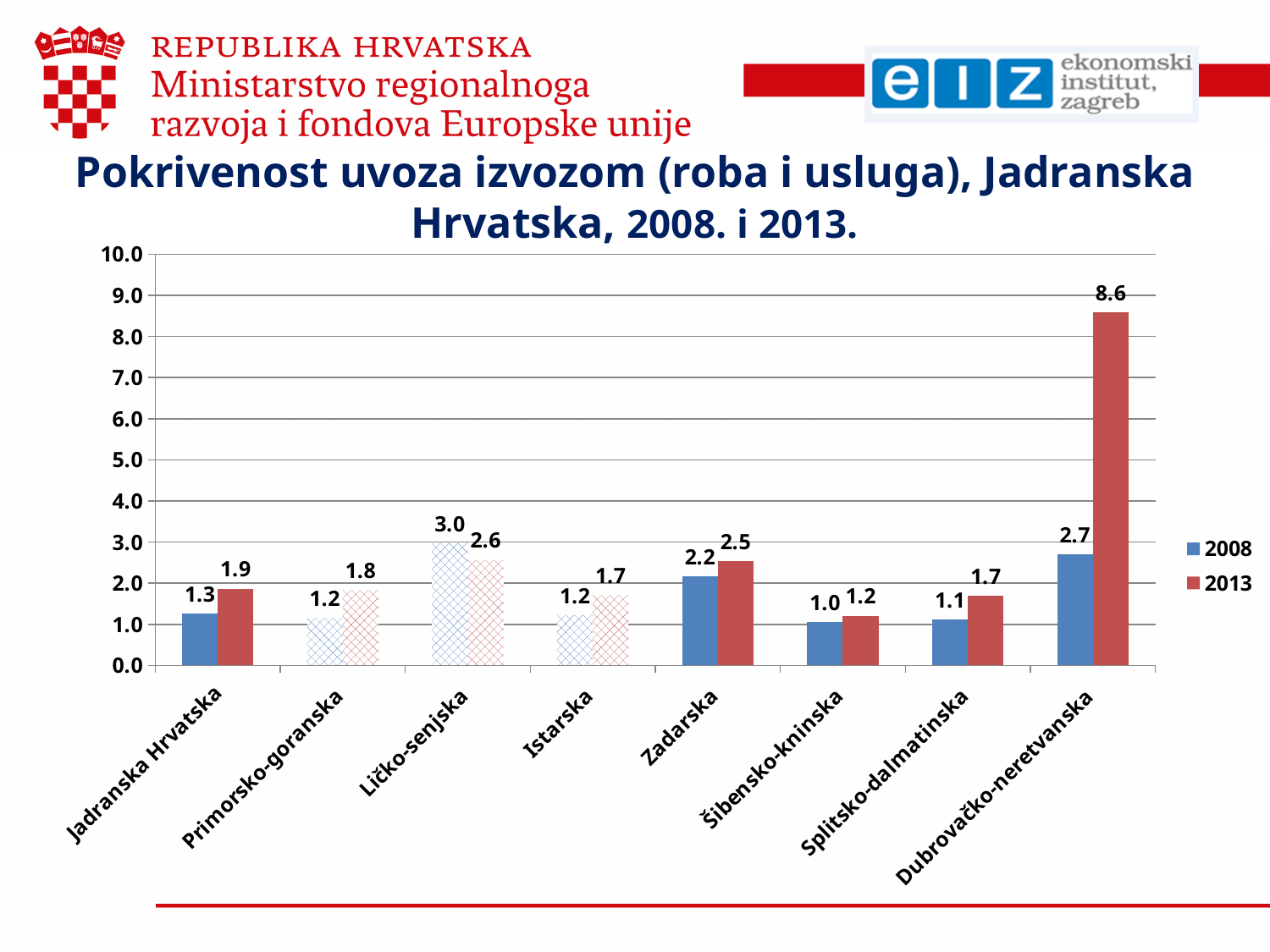
Which years are listed in the legend? 2008 and 2013 Which is larger for Ličko-senjska, the 2008 value or the 2013 value? 2008 What kind of chart is shown on the slide? bar chart How many categories are shown on the x axis? 8 What is the 2013 value for Zadarska? 2.5 What is the 2008 value for Ličko-senjska? 3.0 Is the 2013 value for Dubrovačko-neretvanska greater or less than 8.0? greater What is the difference between the 2013 and 2008 values for Dubrovačko-neretvanska? 5.9 Which category has the lowest 2008 value? Šibensko-kninska Which category has the highest 2013 value? Dubrovačko-neretvanska What is the 2013 value for Dubrovačko-neretvanska? 8.6 How many series does the legend list? 2